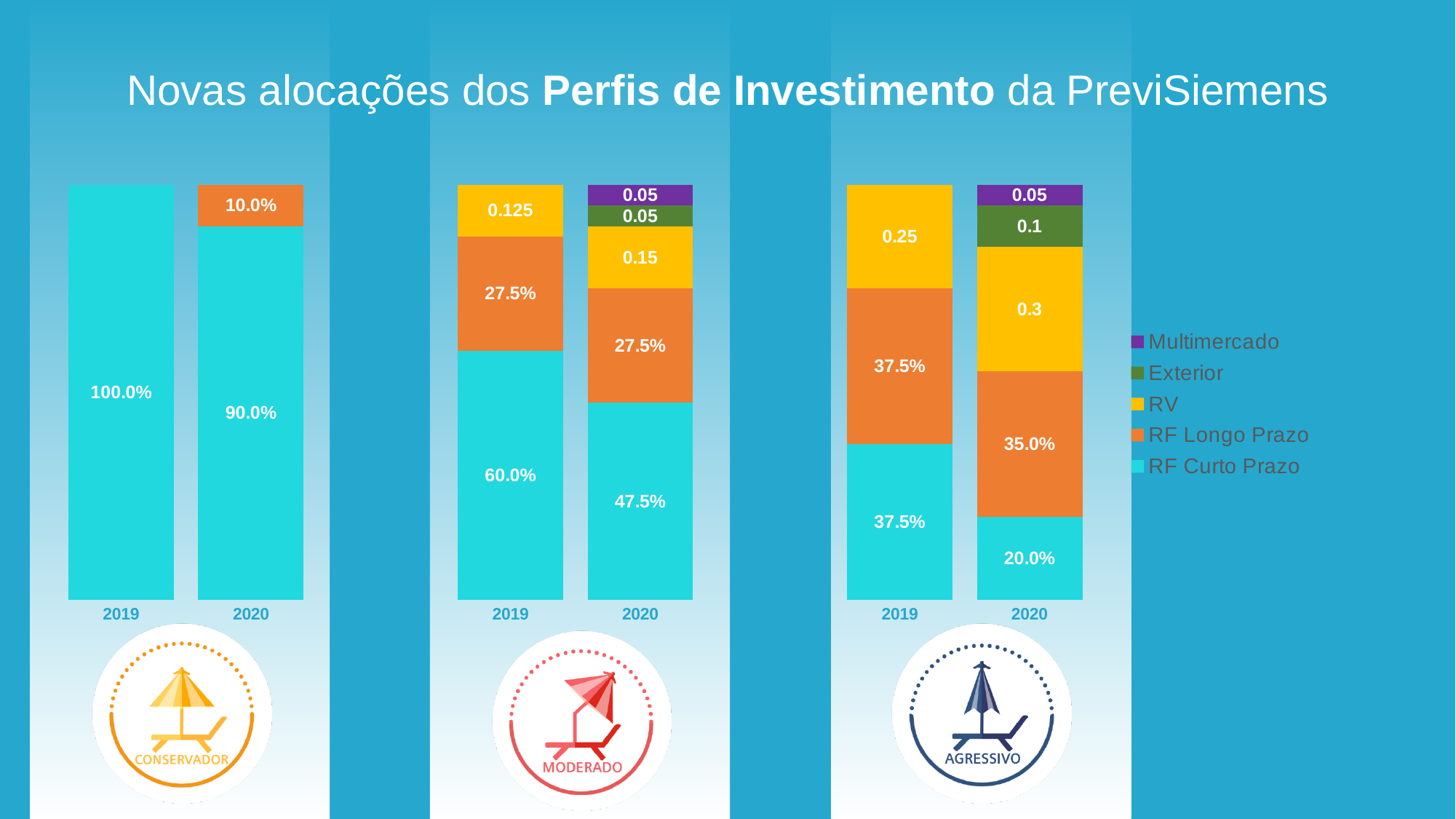
In the Agressivo chart (right), what is the value for RF Longo Prazo in 2020? 35.0% In the Conservador chart (left), does the RF Curto Prazo value fall or rise from 2019 to 2020? fall In the Moderado chart (middle), what is the value for RF Curto Prazo in 2019? 60.0% In the Agressivo chart (right), what is the value labelled for Exterior in 2020? 0.1 In the Moderado chart (middle), what is the difference between the RF Curto Prazo values for 2019 and 2020? 12.5% How many series does the legend list? 5 Which legend entry is shown in purple? Multimercado In the Moderado chart (middle), what is the value labelled for RV in 2020? 0.15 In the Conservador chart (left), what is the value for RF Curto Prazo in 2020? 90.0% In the Conservador chart (left), what is the value for RF Longo Prazo in 2020? 10.0% What kind of chart is used for each investment profile on the slide? stacked bar chart In the Agressivo chart (right), which is larger: RF Curto Prazo in 2019 or RF Curto Prazo in 2020? 2019